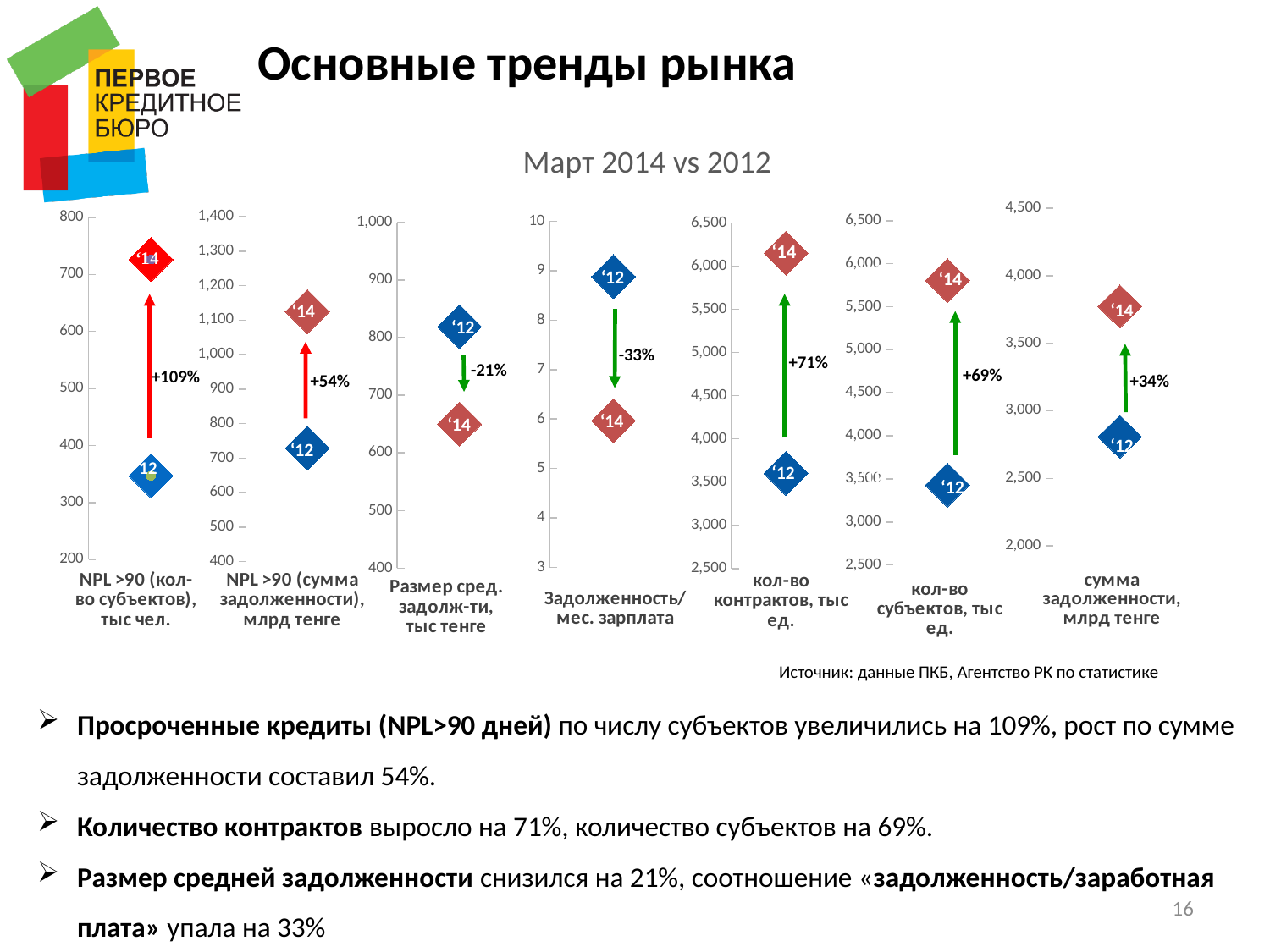
In the chart titled 'кол-во контрактов, тыс ед.', what percentage change is labelled on the arrow? +71% In the chart titled 'Размер сред. задолж-ти, тыс тенге', which point is higher, '12 or '14? '12 In the chart titled 'NPL >90 (кол-во субъектов), тыс чел.', is the value for '14 greater or less than 600? greater In the chart titled 'сумма задолженности, млрд тенге', does the value rise or fall from '12 to '14? rise In the chart titled 'кол-во субъектов, тыс ед.', is the value for '12 greater or less than 4,000? less How many separate charts are shown on the slide? 7 In the chart titled 'сумма задолженности, млрд тенге', what percentage change is shown? +34% In the chart titled 'Задолженность/мес. зарплата', what percentage change is labelled? -33% In the chart titled 'Размер сред. задолж-ти, тыс тенге', what percentage change is shown? -21% In the chart titled 'Задолженность/мес. зарплата', is the value for '12 greater or less than 8? greater In the chart titled 'NPL >90 (кол-во субъектов), тыс чел.', what percentage change is labelled between '12 and '14? +109% In the chart titled 'NPL >90 (сумма задолженности), млрд тенге', what percentage change is labelled on the arrow? +54%